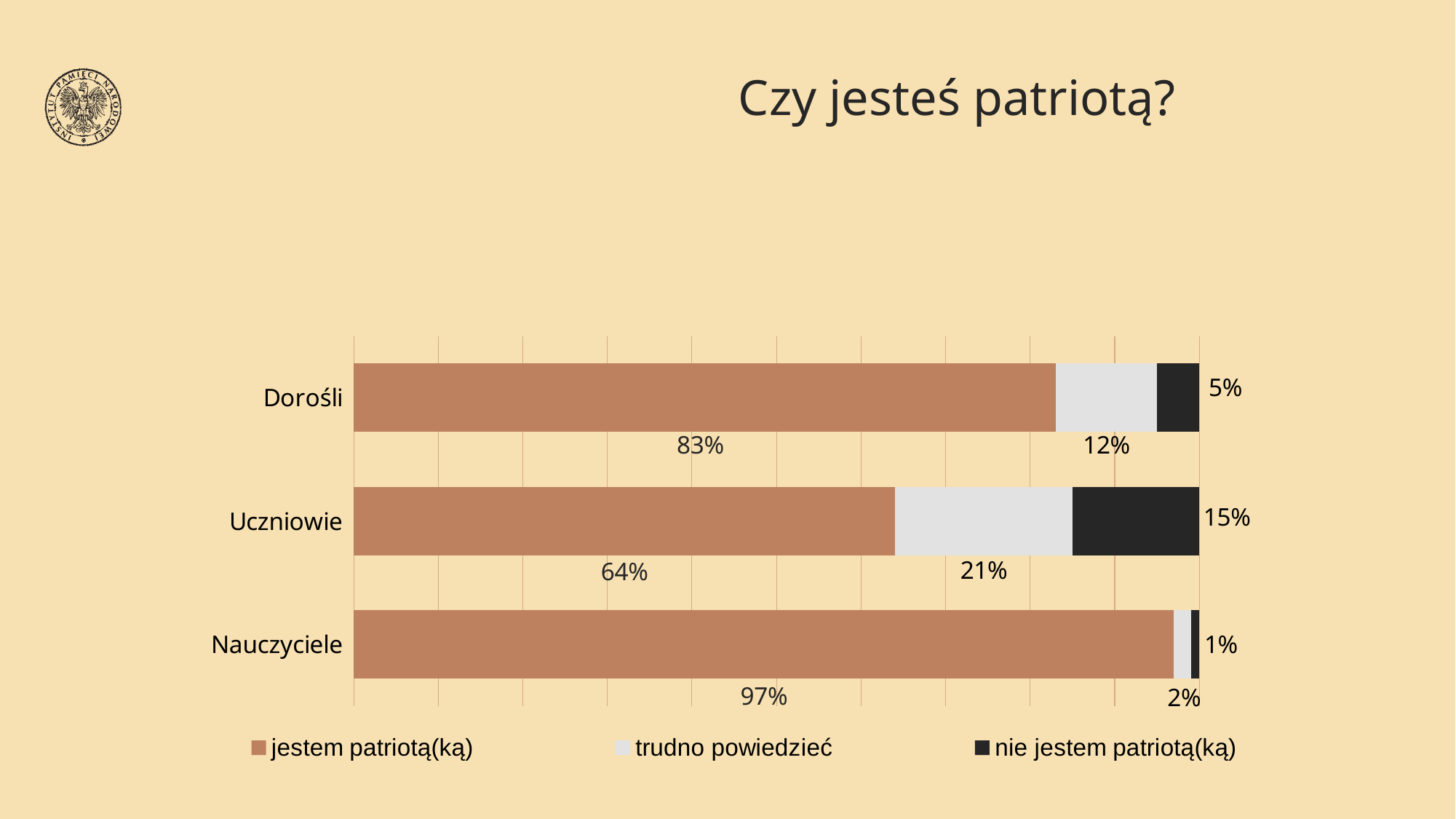
What is the title of the slide? Czy jesteś patriotą? Which group has the highest share answering "jestem patriotą(ką)"? Nauczyciele What percentage of Nauczyciele answered "nie jestem patriotą(ką)"? 1% Which is larger: the "trudno powiedzieć" share for Dorośli or for Uczniowie? Uczniowie What percentage of Uczniowie answered "trudno powiedzieć"? 21% What percentage of Dorośli answered "jestem patriotą(ką)"? 83% How many series does the legend list? 3 What kind of chart is shown on the slide? Stacked bar chart What percentage of Uczniowie answered "nie jestem patriotą(ką)"? 15% How many groups are shown on the chart? 3 What is the difference between the "jestem patriotą(ką)" share for Nauczyciele and for Uczniowie? 33 percentage points Which group has the lowest share answering "jestem patriotą(ką)"? Uczniowie